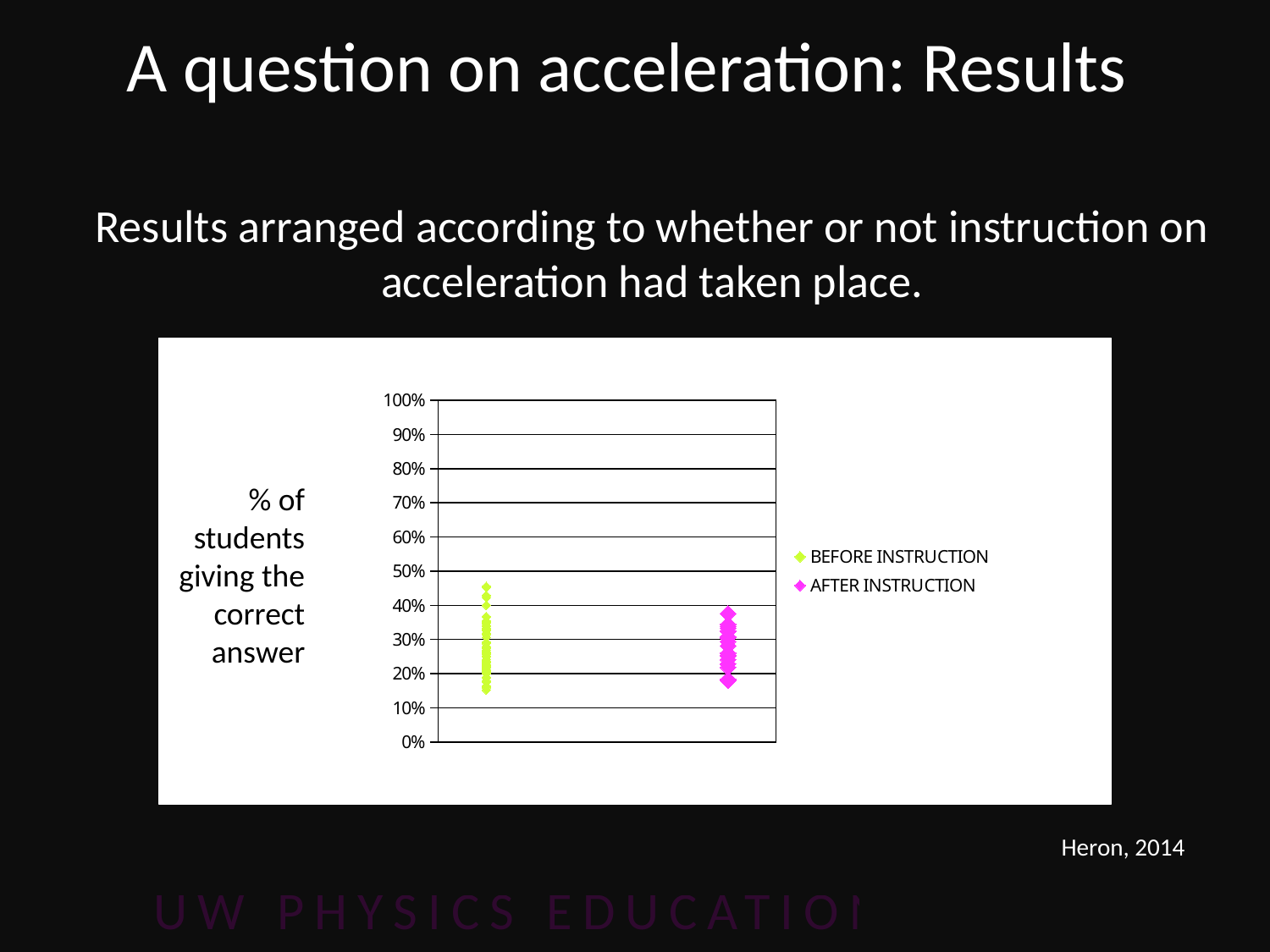
Are all of the points in the chart, for both series, greater or less than 60%? less Is the lowest AFTER INSTRUCTION point greater or less than 10%? greater What colour are the AFTER INSTRUCTION markers in the chart? Magenta (pink) What is the maximum value shown on the chart's vertical axis? 100% Is the highest BEFORE INSTRUCTION point greater or less than 40%? greater How many series does the chart legend list? 2 What are the two series named in the chart legend? BEFORE INSTRUCTION and AFTER INSTRUCTION What kind of chart is shown on the slide? Scatter chart What is the interval between consecutive tick marks on the chart's vertical axis? 10%